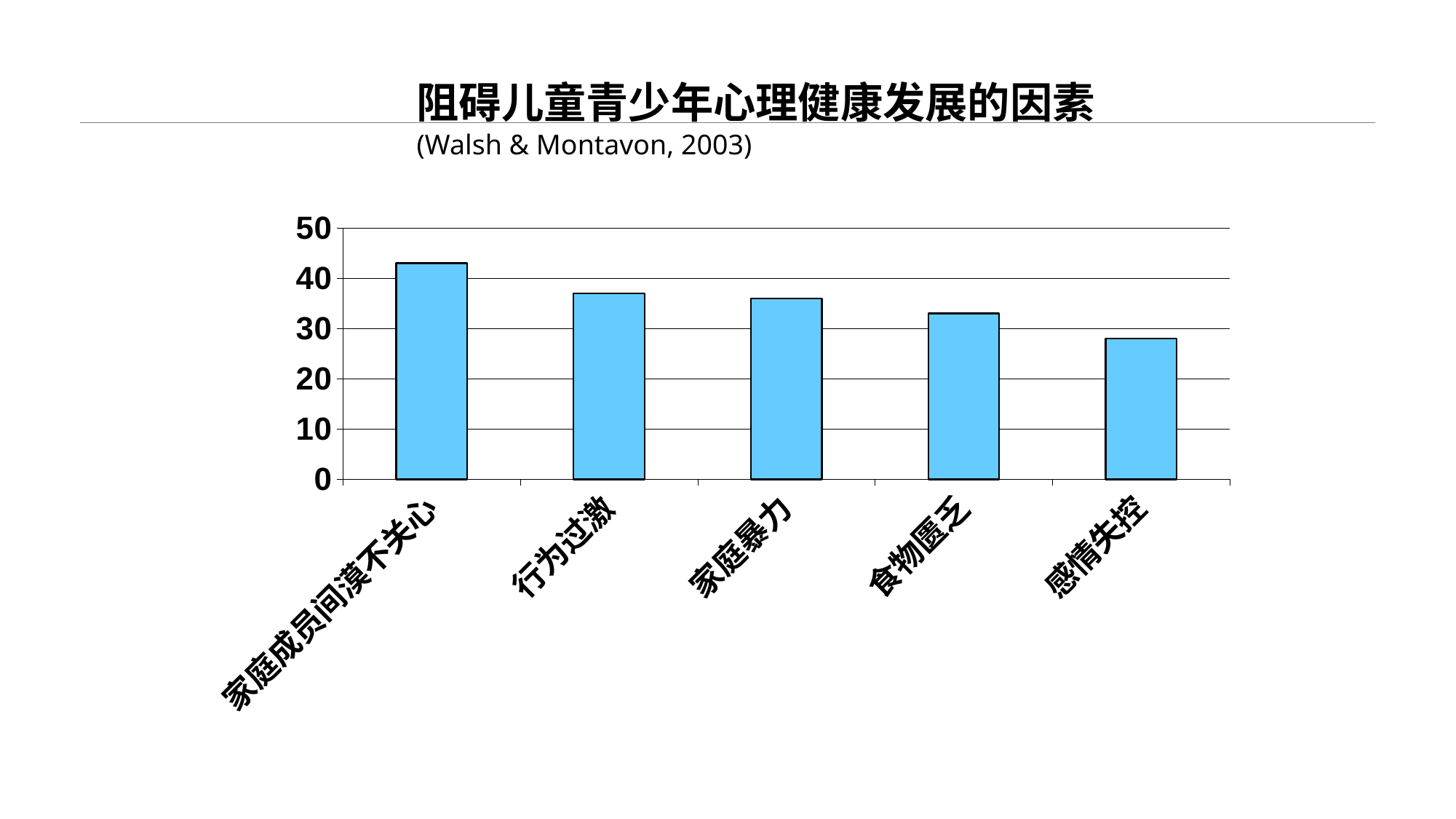
What kind of chart is shown on the slide? bar chart Which category has the lowest bar? 感情失控 How many categories are plotted in the chart? 5 Do the bar values rise or fall from left to right across the categories? fall Which category has the highest bar? 家庭成员间漠不关心 Is the value for 感情失控 greater or less than 30? less Is the value for 行为过激 greater or less than 40? less Is the value for 家庭暴力 greater or less than 30? greater Which is larger, the value for 家庭成员间漠不关心 or the value for 感情失控? 家庭成员间漠不关心 What is the title of the chart on the slide? 阻碍儿童青少年心理健康发展的因素